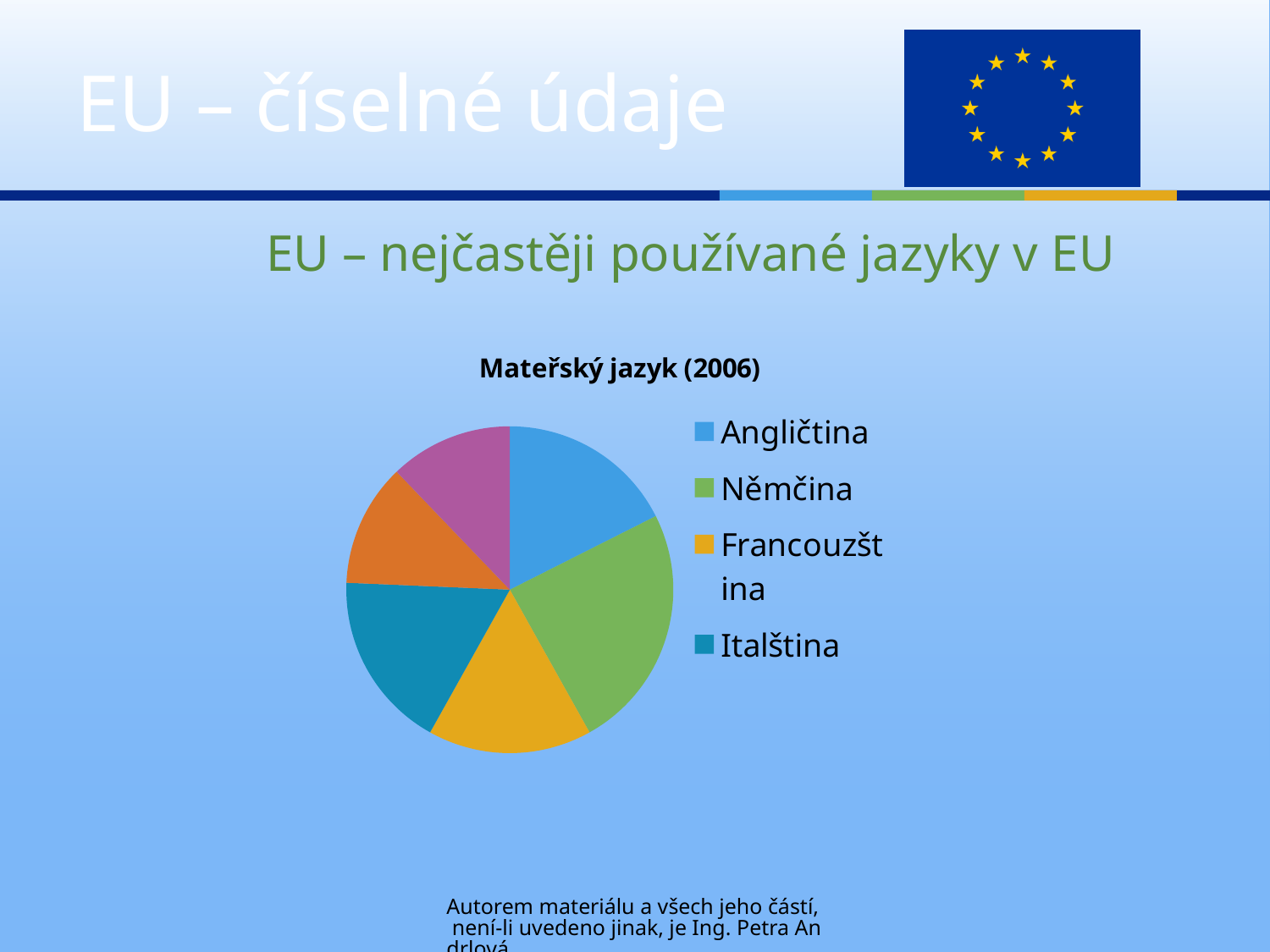
Which colour represents Angličtina in the pie chart? blue What kind of chart is shown on the slide? pie chart Which language has the largest slice in the pie chart? Němčina How many slices does the pie chart have? 6 Which slice is larger, Němčina or Francouzština? Němčina What is the title of the chart? Mateřský jazyk (2006) Which slice is larger, Němčina or Angličtina? Němčina How many entries does the chart's legend list? 4